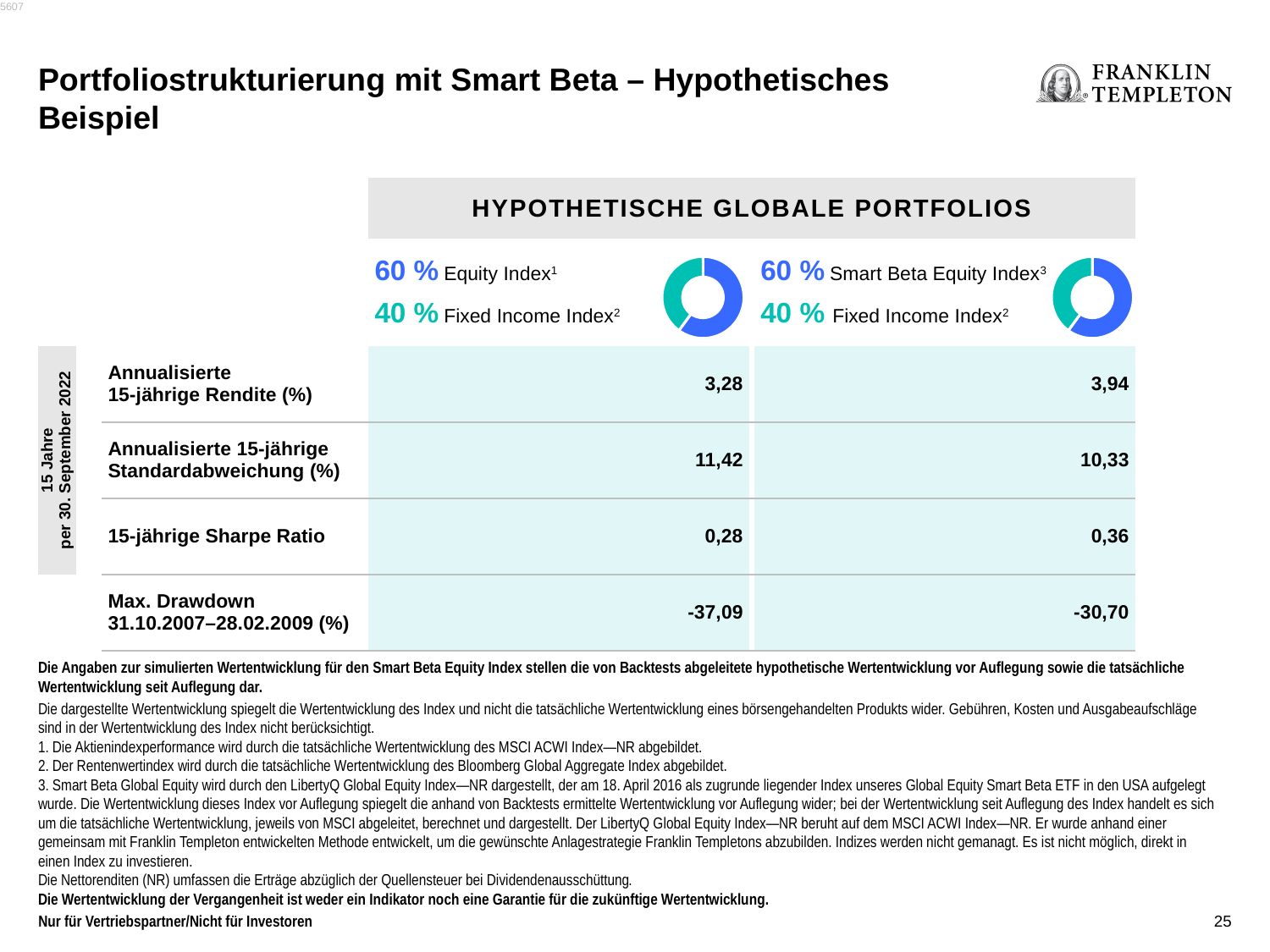
How many slices does the left donut chart have? 2 In the left donut chart, what share of the portfolio is the Fixed Income Index? 40 % What kind of chart is shown next to the '60 % Equity Index / 40 % Fixed Income Index' allocation on the left? Pie chart (donut) In the right donut chart, what share of the portfolio is the Fixed Income Index? 40 % How many donut charts are shown on the slide? 2 What colour is the Fixed Income Index slice in the donut charts? Green What is the heading above the two donut charts? HYPOTHETISCHE GLOBALE PORTFOLIOS In the left donut chart, what share of the portfolio is the Equity Index? 60 % In the left donut chart, what is the difference in percentage points between the Equity Index share and the Fixed Income Index share? 20 In the left donut chart, which slice is the smallest? Fixed Income Index In the right donut chart, which slice is larger: Smart Beta Equity Index or Fixed Income Index? Smart Beta Equity Index